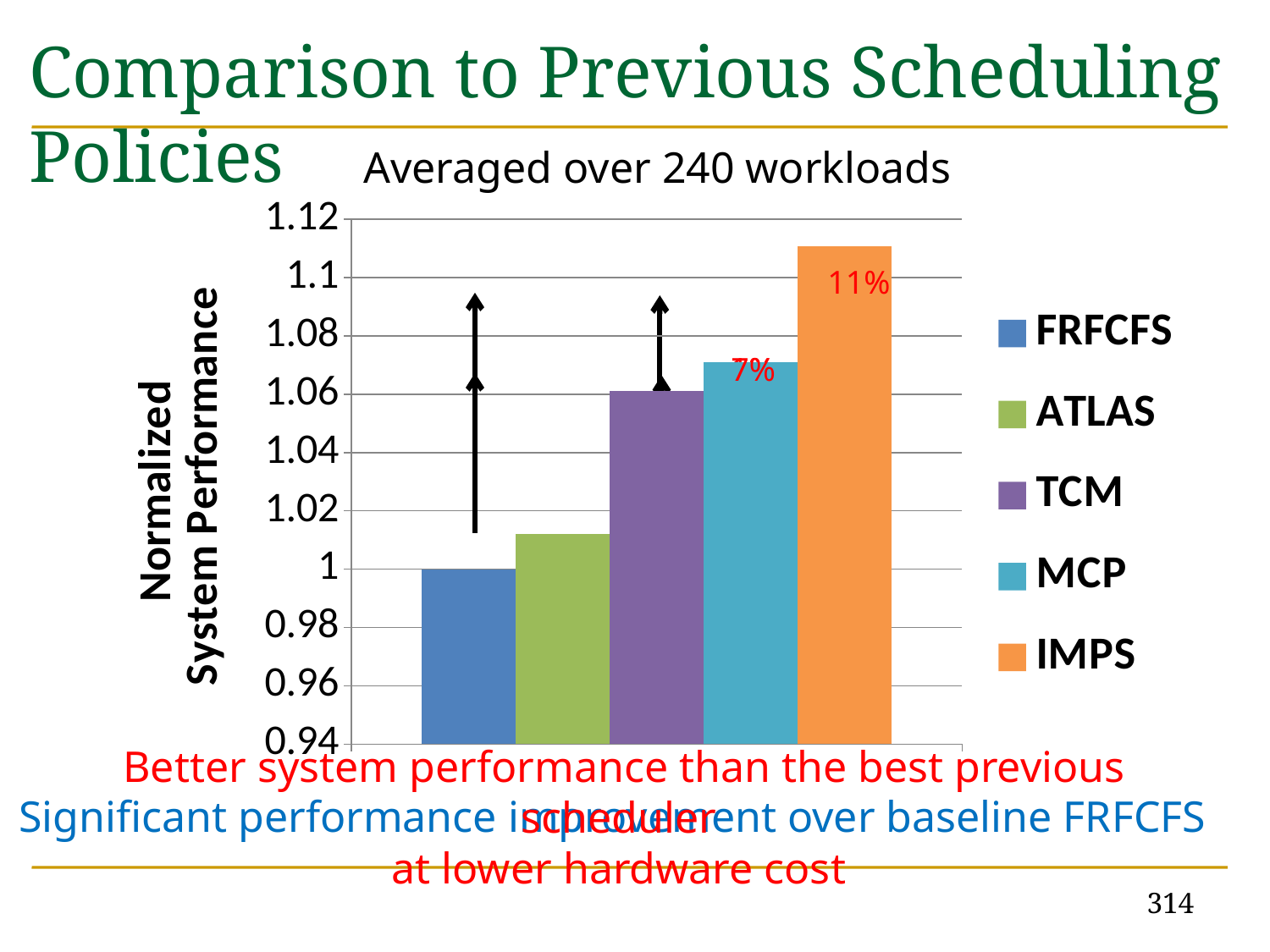
What is the title of the chart? Averaged over 240 workloads How many series does the legend list? 5 Is the value for TCM greater or less than 1.04? greater Which scheduling policy has the highest normalized system performance? IMPS Do the bar values rise or fall from left to right across the chart? rise How many bars are plotted in the chart? 5 Is the value for IMPS greater or less than 1.1? greater Is the value for ATLAS greater or less than 1.02? less What kind of chart is shown on the slide? bar chart Which scheduling policy has the lowest normalized system performance? FRFCFS What is the normalized system performance of FRFCFS? 1 Which has a higher normalized system performance, ATLAS or TCM? TCM